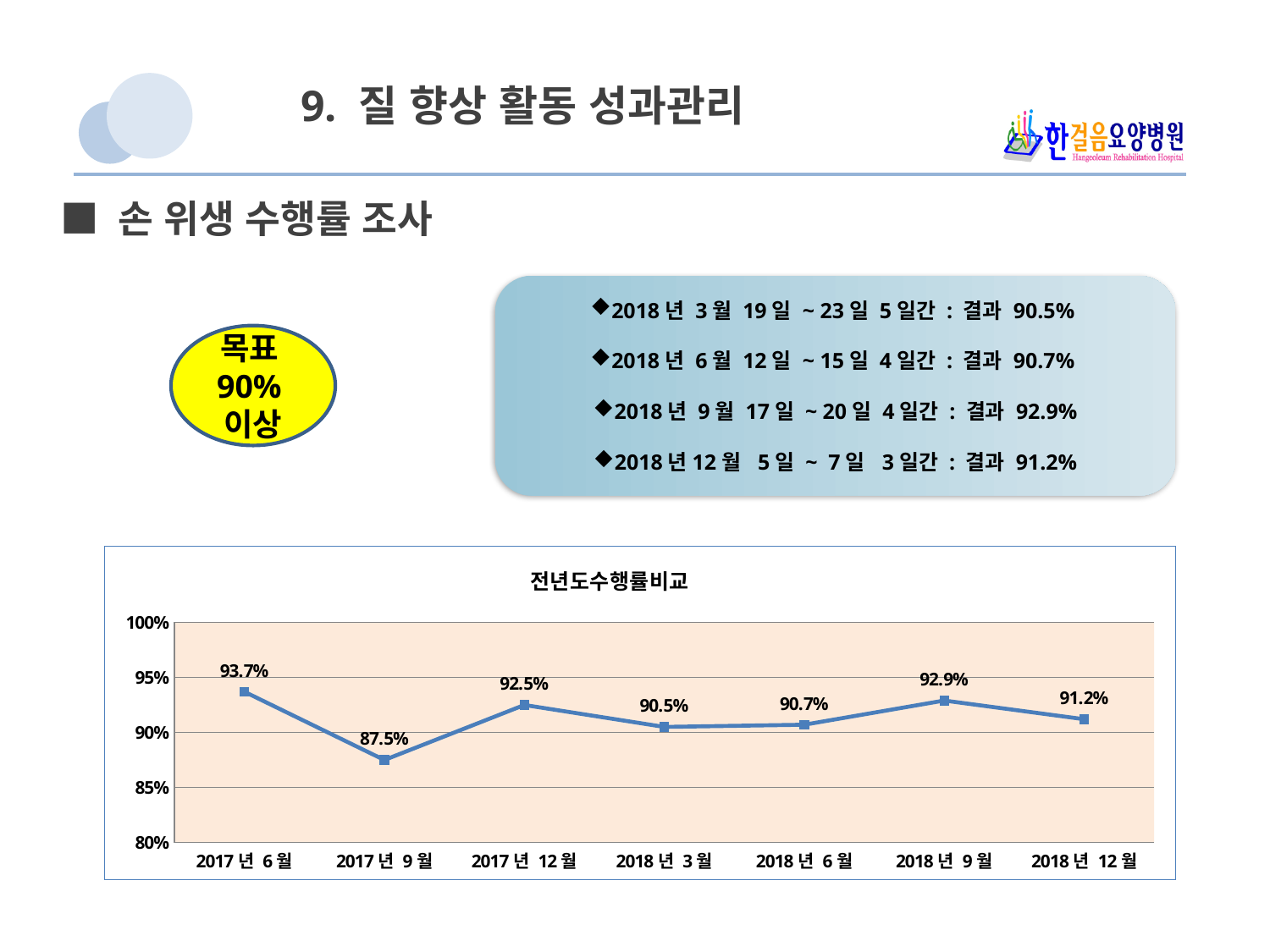
What is the difference between the values for 2018년 9월 and 2018년 12월? 1.7% Which period has the highest value in the chart? 2017년 6월 How many data points are plotted in the chart? 7 What is the value for 2018년 12월 in the chart? 91.2% What is the value for 2017년 6월 in the chart? 93.7% Which period has the lowest value in the chart? 2017년 9월 What is the value for 2017년 9월 in the chart? 87.5% Which is larger, the value for 2017년 12월 or the value for 2018년 3월? 2017년 12월 What is the value for 2018년 9월 in the chart? 92.9% What is the difference between the values for 2017년 6월 and 2017년 9월? 6.2% What kind of chart is shown on the slide? Line chart What is the title of the chart? 전년도수행률비교